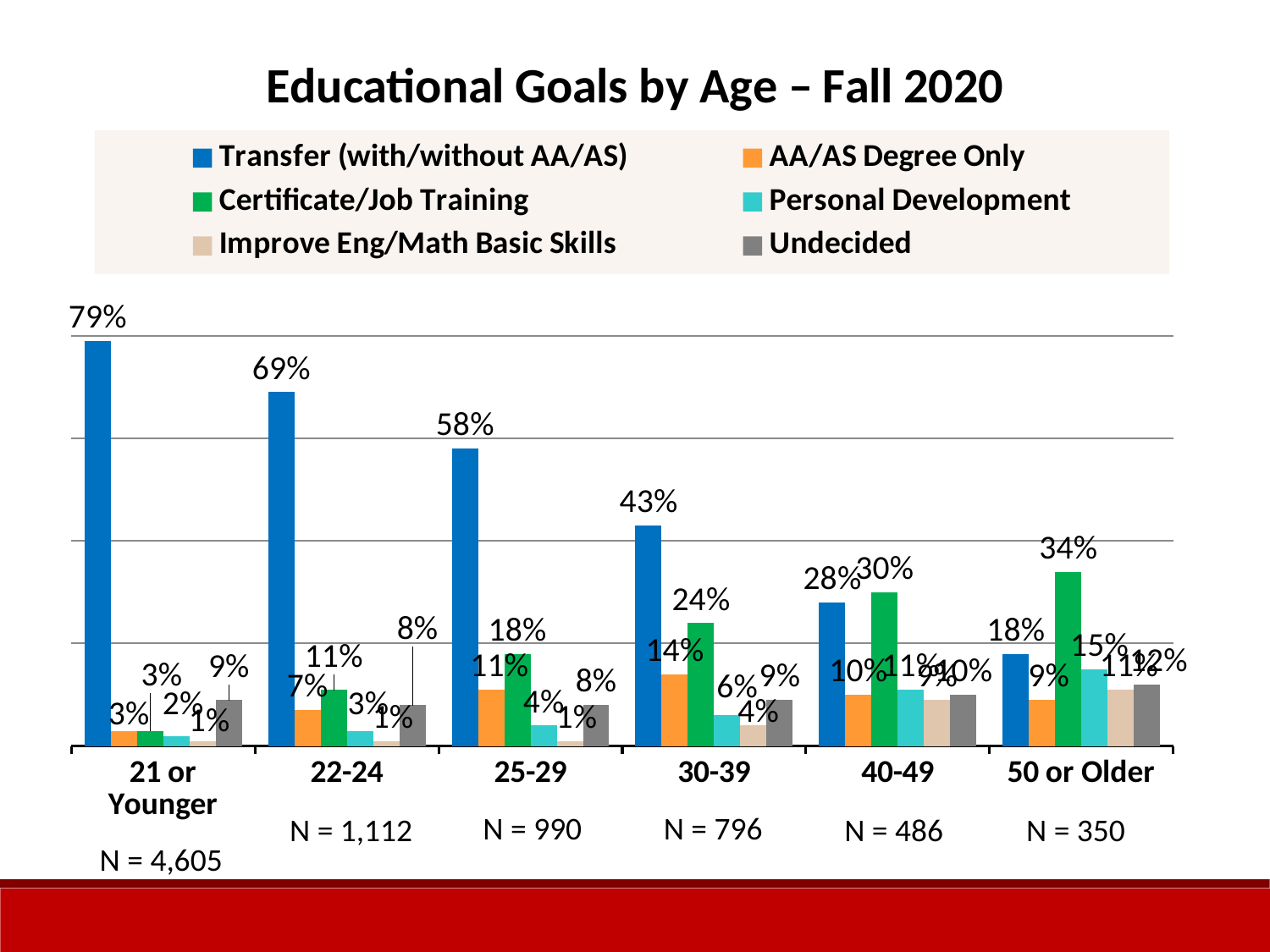
How does the Transfer (with/without AA/AS) value change as the age groups get older? It falls In the 40-49 age group, which is larger: Transfer (with/without AA/AS) or Certificate/Job Training? Certificate/Job Training How many age groups are shown on the x axis? 6 What kind of chart is shown on the slide? Bar chart Which age group has the highest value for Transfer (with/without AA/AS)? 21 or Younger What is the value for Certificate/Job Training in the 50 or Older age group? 34% What is the difference between the Transfer (with/without AA/AS) values for 21 or Younger and 22-24? 10 percentage points What is the value for Certificate/Job Training in the 30-39 age group? 24% What is the value for Transfer (with/without AA/AS) in the 21 or Younger age group? 79% Which age group has the lowest value for Transfer (with/without AA/AS)? 50 or Older How many series does the legend list? 6 What is the title of the chart? Educational Goals by Age – Fall 2020